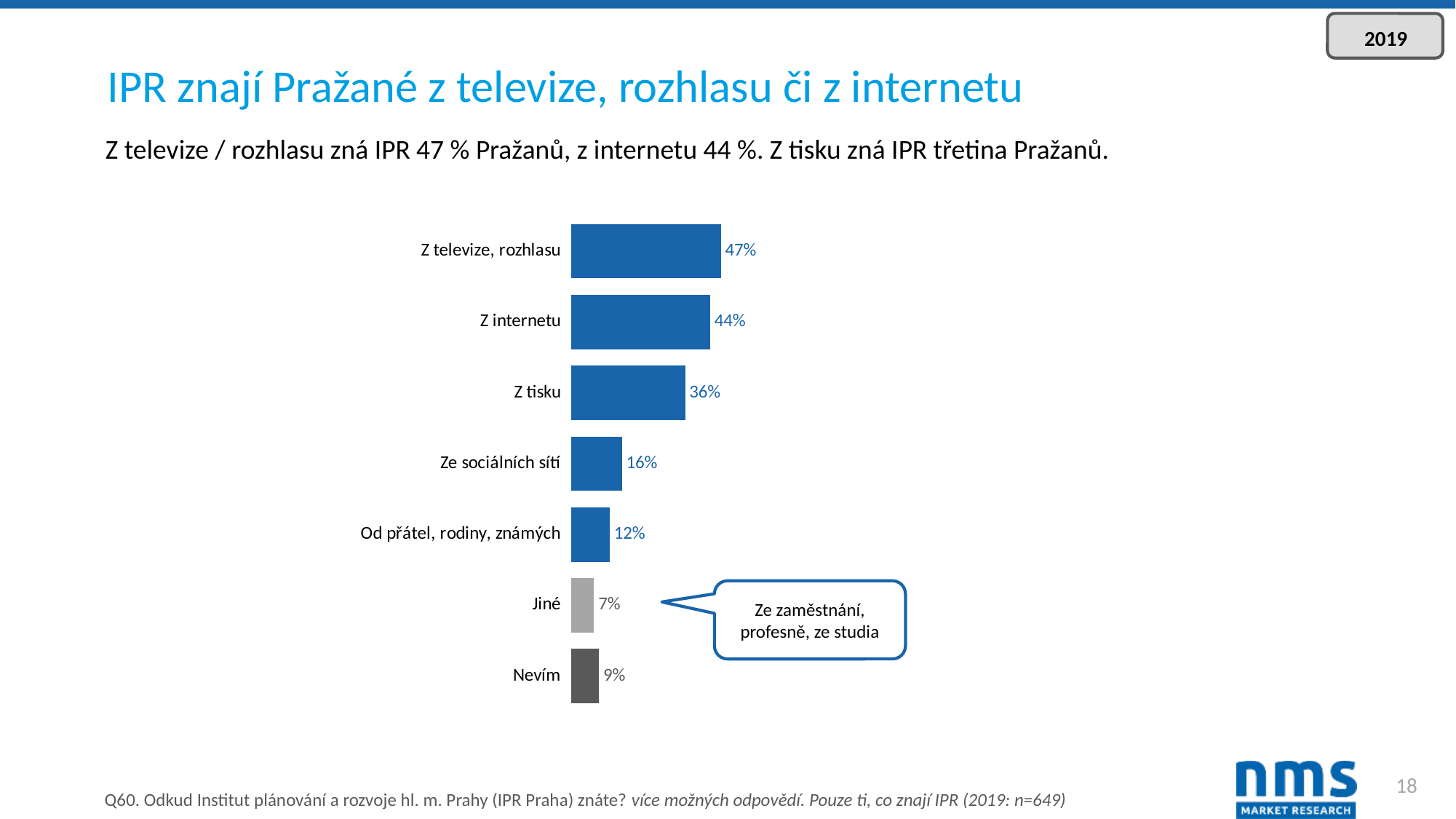
Which is larger, the value for "Od přátel, rodiny, známých" or the value for "Nevím"? Od přátel, rodiny, známých How many categories are shown in the chart? 7 What does the callout next to the "Jiné" bar say? Ze zaměstnání, profesně, ze studia What is the value for "Nevím"? 9% What is the value for "Z internetu"? 44% Which category has the lowest value? Jiné What is the difference between the values for "Z televize, rozhlasu" and "Z tisku"? 11% Which category has the highest value? Z televize, rozhlasu What is the value for "Ze sociálních sítí"? 16% What kind of chart is shown on the slide? Bar chart Which category's bar is coloured dark grey? Nevím What is the value for "Z televize, rozhlasu"? 47%